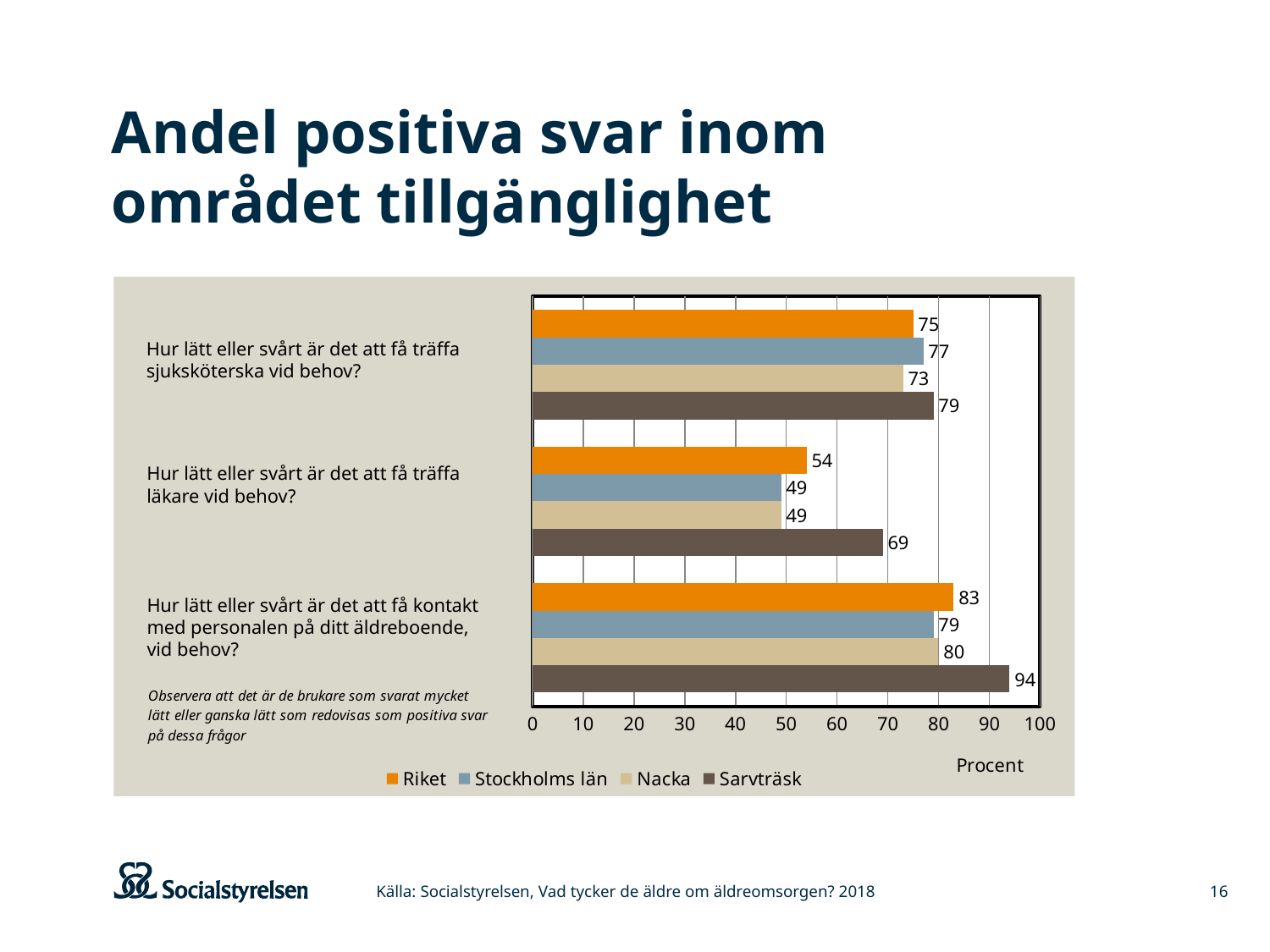
What kind of chart is shown on the slide? Bar chart What is the value for Nacka on the question about meeting a nurse when needed ("Hur lätt eller svårt är det att få träffa sjuksköterska vid behov?")? 73 What is the value for Riket on the question about meeting a doctor when needed ("Hur lätt eller svårt är det att få träffa läkare vid behov?")? 54 Which series has the highest value on the question about meeting a doctor when needed? Sarvträsk How many series does the legend list? 4 What is the value for Sarvträsk on the question about getting in contact with staff at the care home ("Hur lätt eller svårt är det att få kontakt med personalen på ditt äldreboende, vid behov?")? 94 How many questions (categories) are shown on the chart? 3 Which is larger on the question about meeting a nurse when needed: Stockholms län or Riket? Stockholms län What is the difference between Sarvträsk and Riket on the question about getting in contact with staff at the care home? 11 Which series has the lowest value on the question about meeting a nurse when needed? Nacka What is the difference between Sarvträsk and Stockholms län on the question about meeting a doctor when needed? 20 What is the label on the horizontal axis of the chart? Procent